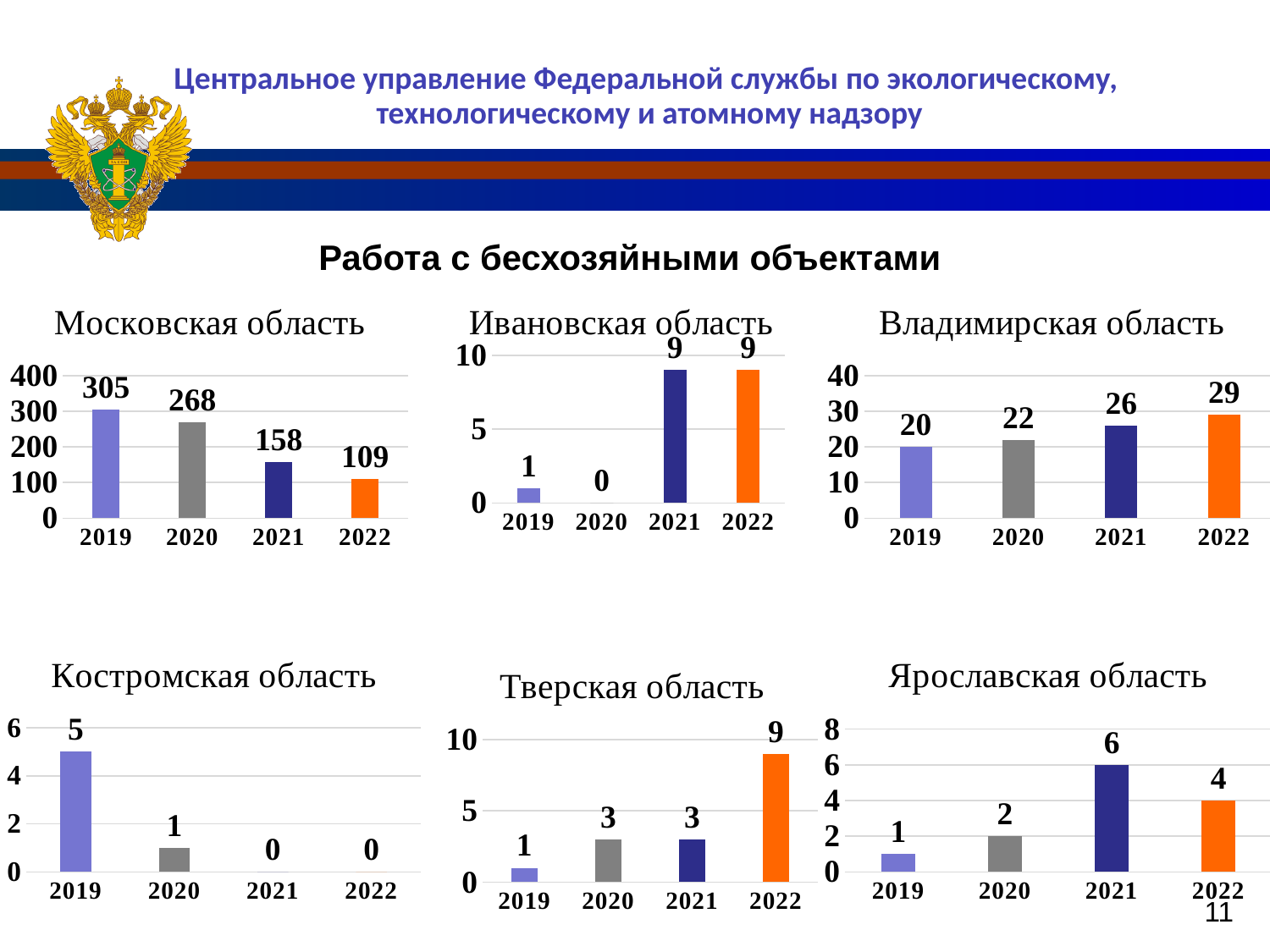
In the 'Тверская область' chart, which is larger, the value for 2020 or the value for 2022? 2022 In the 'Костромская область' chart, what is the value for 2019? 5 In the 'Владимирская область' chart, which year has the highest value? 2022 In the 'Московская область' chart, what is the value for 2019? 305 What kind of chart is the 'Тверская область' chart? bar chart How many categories does the 'Ярославская область' chart show? 4 In the 'Ивановская область' chart, which year has the lowest value? 2020 In the 'Ивановская область' chart, what is the value for 2020? 0 In the 'Московская область' chart, what is the difference between the values for 2019 and 2022? 196 In the 'Владимирская область' chart, do the values rise or fall from 2019 to 2022? rise In the 'Ярославская область' chart, what is the difference between the values for 2021 and 2022? 2 In the 'Московская область' chart, do the values rise or fall from 2019 to 2022? fall